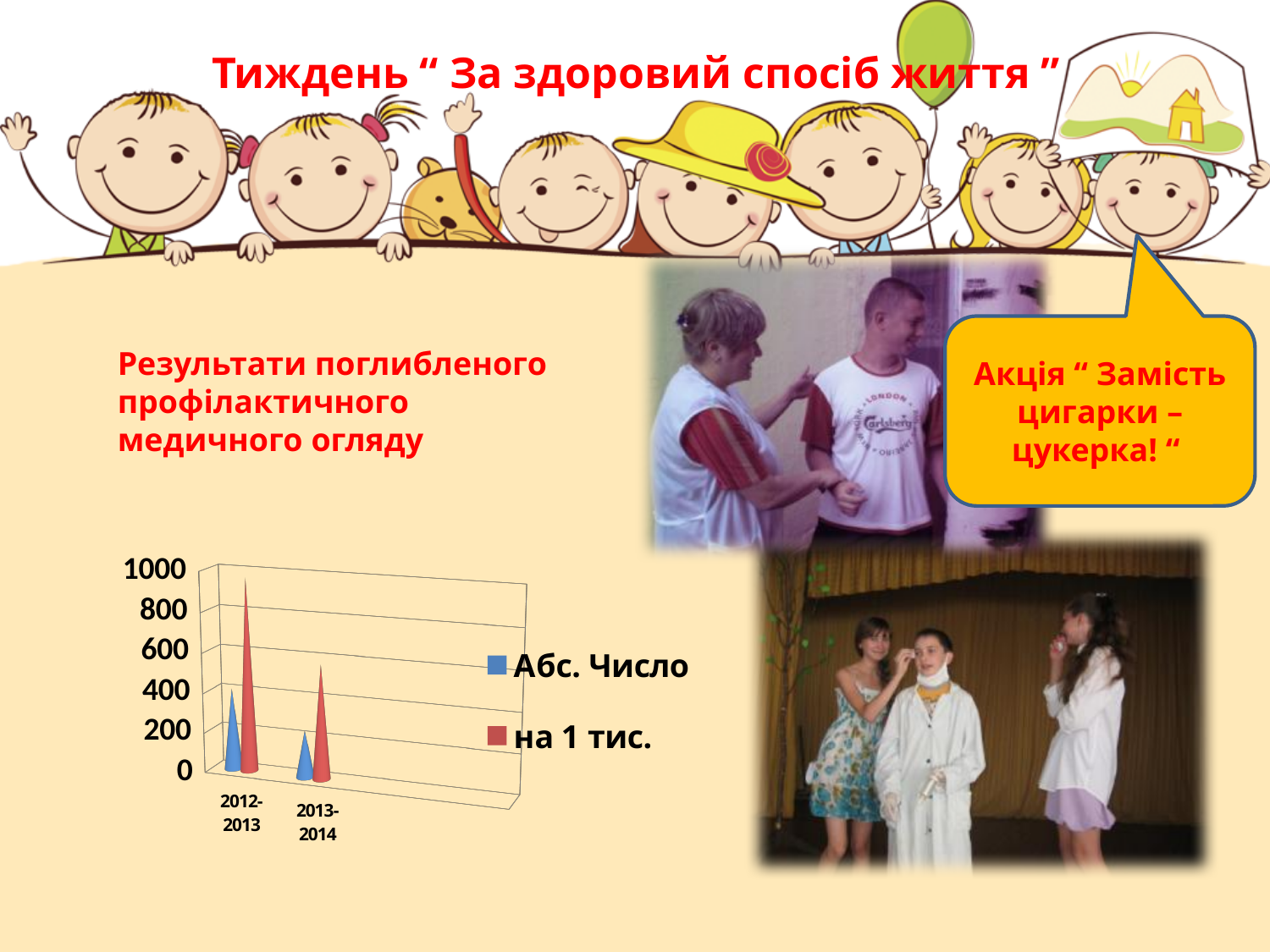
Which category has the lowest value for the series 'Абс. Число'? 2013-2014 What are the two series named in the chart legend? Абс. Число and на 1 тис. Is the value for 'на 1 тис.' in 2012-2013 greater or less than 600? greater How many categories are shown on the x axis of the chart? 2 Is the value for 'Абс. Число' in 2013-2014 greater or less than 400? less Is the value for 'Абс. Число' in 2012-2013 greater or less than 600? less Do the values for 'на 1 тис.' rise or fall from 2012-2013 to 2013-2014? fall What kind of chart is shown on the slide? bar chart How many series does the chart legend list? 2 In 2012-2013, which series has the larger value: 'Абс. Число' or 'на 1 тис.'? на 1 тис. Which category has the highest value for the series 'на 1 тис.'? 2012-2013